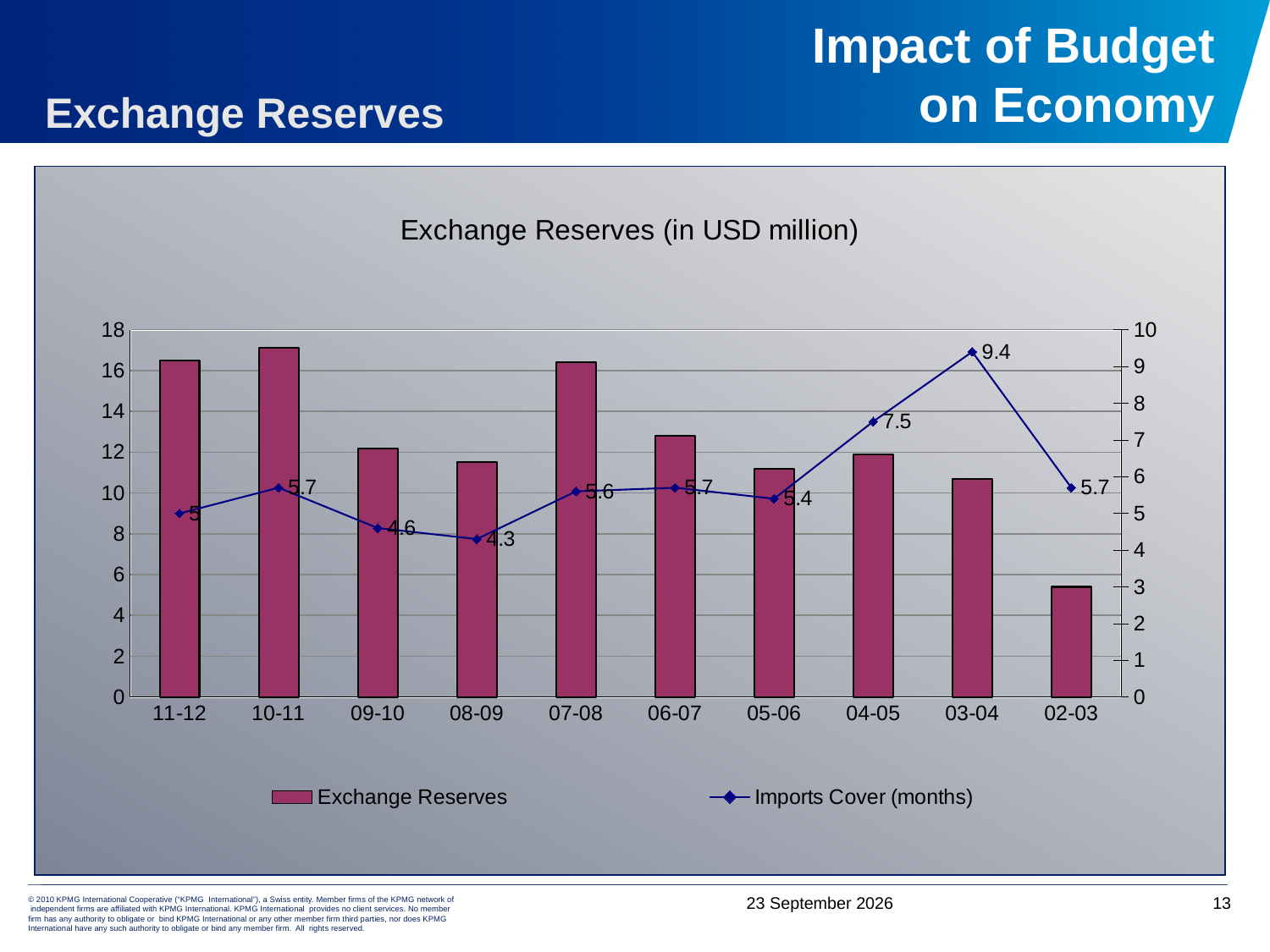
What is the Imports Cover (months) value for 08-09? 4.3 Which year has the lowest Exchange Reserves bar? 02-03 What is the difference between the Imports Cover (months) for 03-04 and 08-09? 5.1 Which year has the lowest Imports Cover (months)? 08-09 What is the Imports Cover (months) value for 04-05? 7.5 Is the Exchange Reserves value for 10-11 greater or less than 16? greater Which year has a higher Imports Cover (months), 04-05 or 05-06? 04-05 What is the Imports Cover (months) value for 03-04? 9.4 Is the Exchange Reserves value for 02-03 greater or less than 6? less Which year has the highest Imports Cover (months)? 03-04 How many years are shown on the x axis? 10 How many series does the legend list? 2